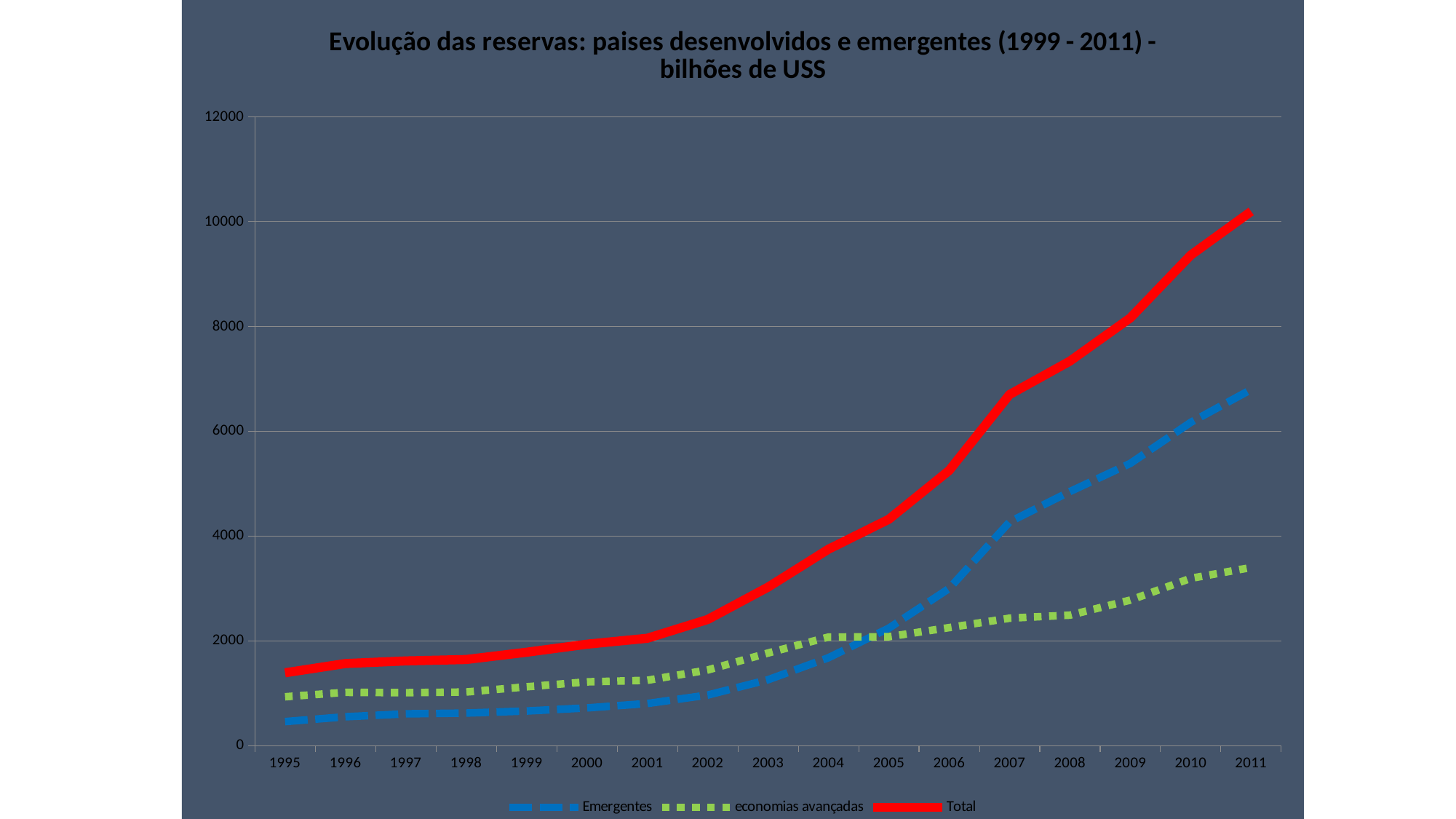
Is the value for Emergentes in 1995 greater or less than 2000? less In 2011, which is larger: Emergentes or economias avançadas? Emergentes What kind of chart is shown on the slide? line chart How many series does the legend list? 3 Does the Total series rise or fall from 1995 to 2011? rise In 2000, which is larger: Emergentes or economias avançadas? economias avançadas Is the value for economias avançadas in 2011 greater or less than 4000? less How many years are plotted along the x axis? 17 Is the value for Emergentes in 2011 greater or less than 6000? greater In which year does the Total series reach its highest value? 2011 What colour is the Total line in the legend? red